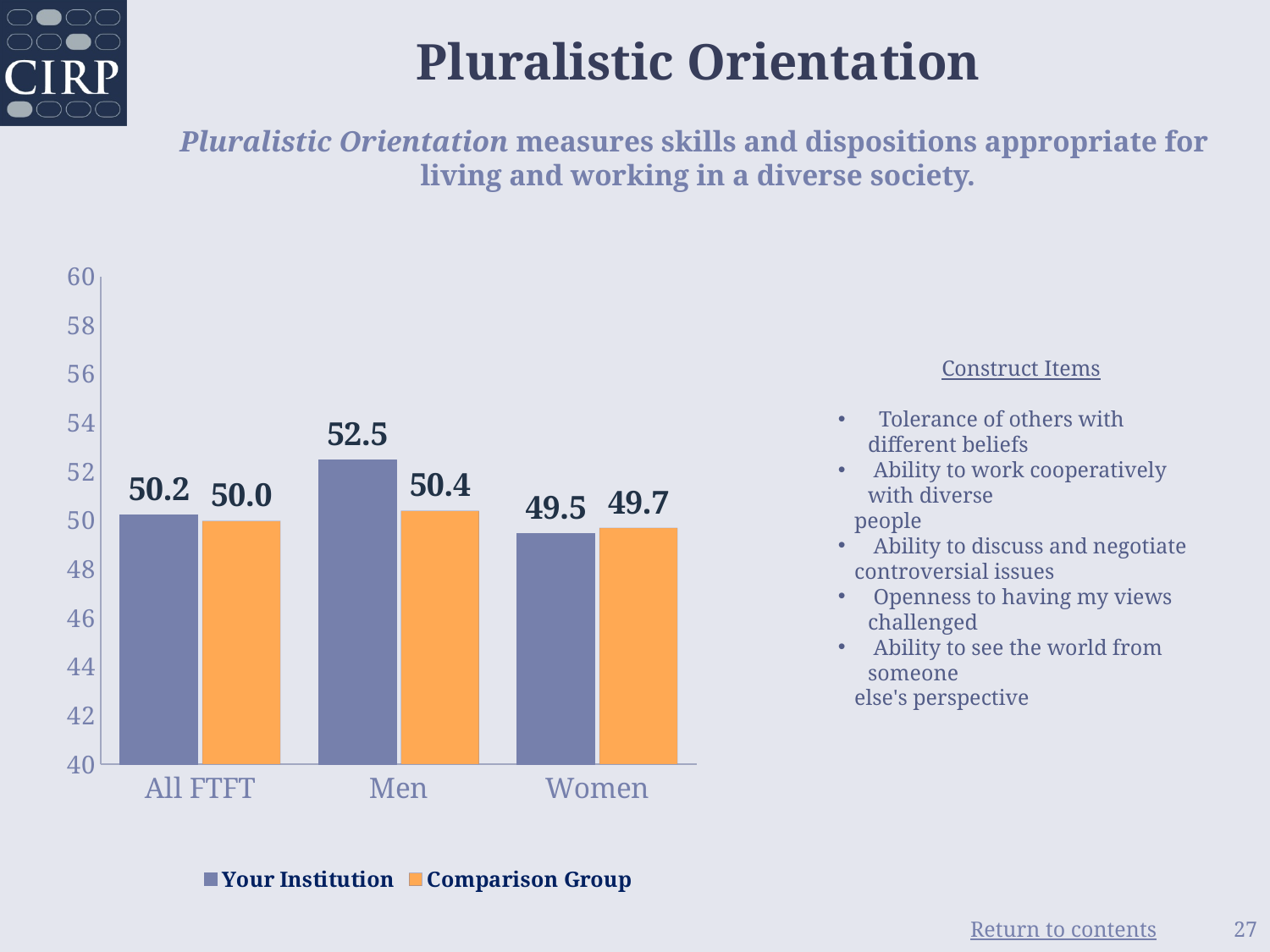
How many categories are shown on the x axis? 3 Which category has the highest Your Institution value? Men Is the Your Institution value for Men greater or less than 52? greater What colour are the Comparison Group bars? orange What is the Your Institution value for Men? 52.5 What is the Your Institution value for All FTFT? 50.2 What kind of chart is shown on the slide? bar chart Which is larger for Women: Your Institution or Comparison Group? Comparison Group How many series does the legend list? 2 What is the difference between the Your Institution and Comparison Group values for Men? 2.1 What is the Comparison Group value for Women? 49.7 Which category has the lowest Comparison Group value? Women